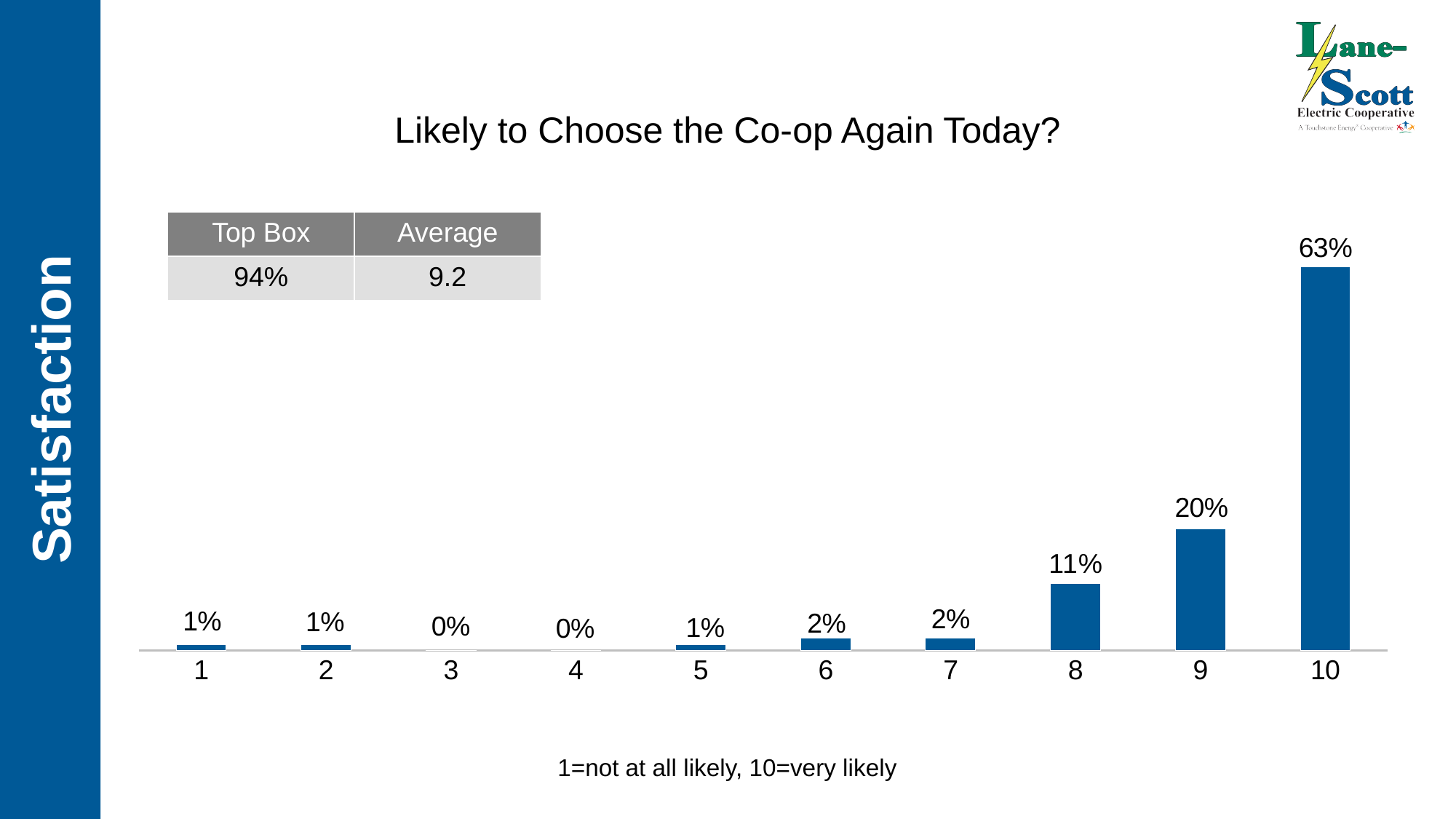
What is the difference in percentage points between ratings 9 and 8? 9 What percentage of respondents gave a rating of 9? 20% What kind of chart is shown on the slide? bar chart What percentage of respondents gave a rating of 10? 63% Which rating has the highest percentage of respondents? 10 What is the difference in percentage points between ratings 10 and 9? 43 Which has a larger percentage, rating 8 or rating 7? 8 How many rating categories are shown on the x axis? 10 What percentage of respondents gave a rating of 8? 11% Do the percentages generally rise or fall from rating 7 to rating 10? rise What is the title of the chart? Likely to Choose the Co-op Again Today? What percentage of respondents gave a rating of 6? 2%